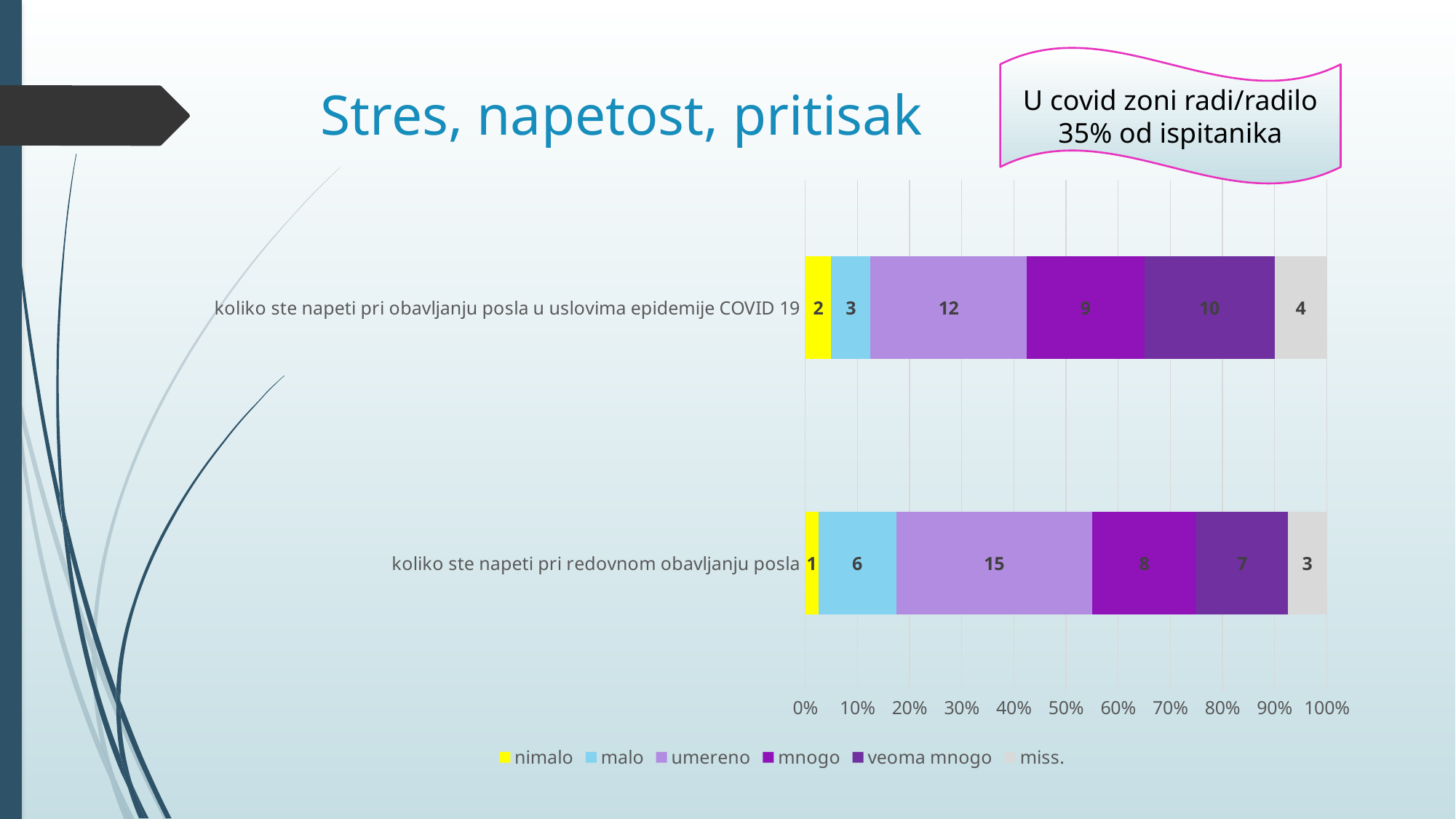
What kind of chart is shown on the slide? stacked bar chart What is the total of all segments in the bar for 'koliko ste napeti pri redovnom obavljanju posla'? 40 What is the value of 'umereno' for 'koliko ste napeti pri obavljanju posla u uslovima epidemije COVID 19'? 12 What is the difference between the 'umereno' values of the two bars? 3 Which series has the lowest value in the bar for 'koliko ste napeti pri obavljanju posla u uslovima epidemije COVID 19'? nimalo What is the value of 'malo' for 'koliko ste napeti pri redovnom obavljanju posla'? 6 How many series does the legend list? 6 What is the value of 'veoma mnogo' for 'koliko ste napeti pri obavljanju posla u uslovima epidemije COVID 19'? 10 What is the value of 'miss.' for 'koliko ste napeti pri redovnom obavljanju posla'? 3 Which bar has the larger 'veoma mnogo' value: the COVID 19 bar or the 'redovnom obavljanju posla' bar? koliko ste napeti pri obavljanju posla u uslovima epidemije COVID 19 Which series has the highest value in the bar for 'koliko ste napeti pri redovnom obavljanju posla'? umereno How many categories (bars) are plotted in the chart? 2